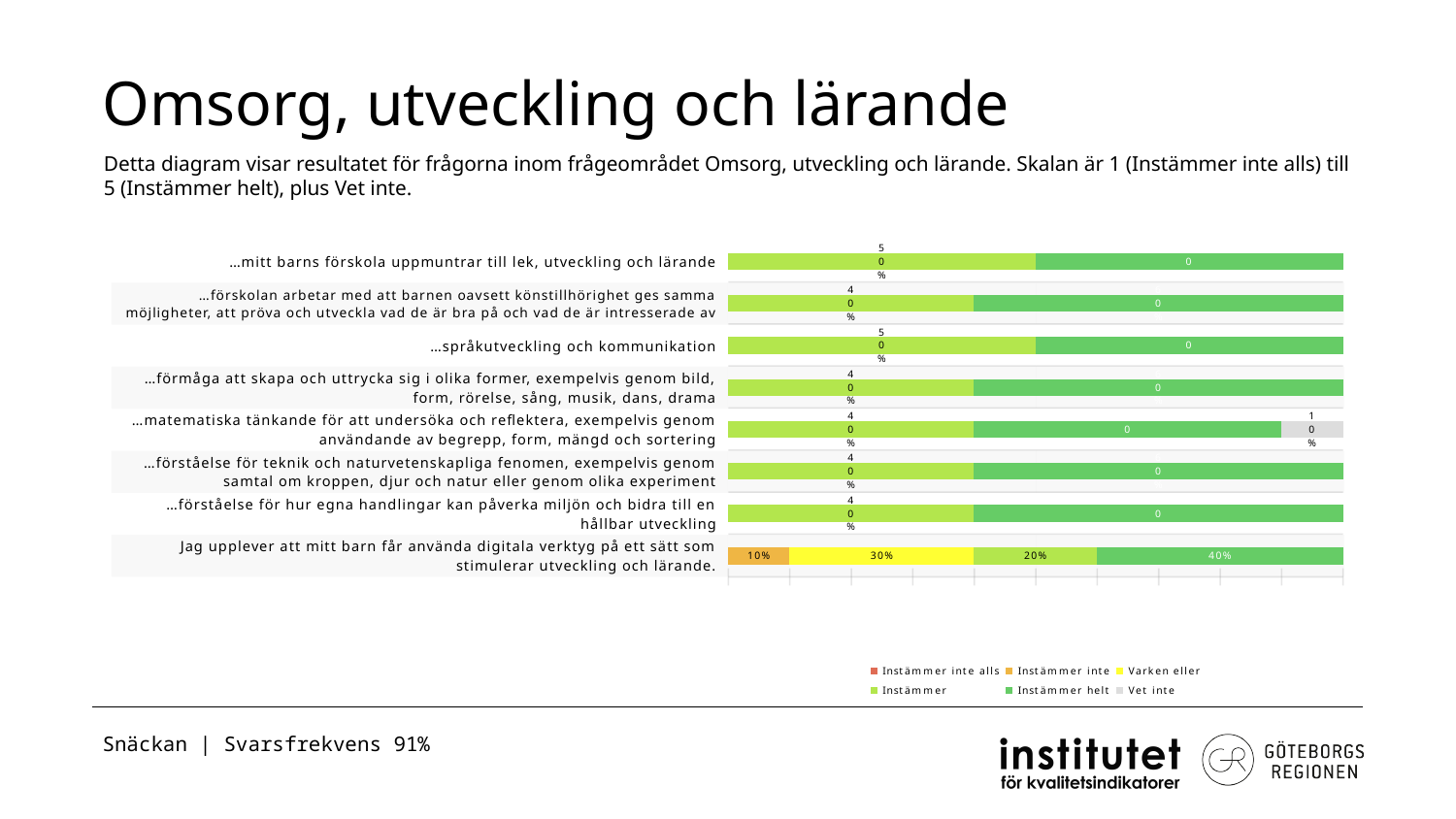
For the statement "…matematiska tänkande för att undersöka och reflektera, exempelvis genom användande av begrepp, form, mängd och sortering", what is the value for Vet inte? 10% For the statement "Jag upplever att mitt barn får använda digitala verktyg på ett sätt som stimulerar utveckling och lärande.", what is the value for Varken eller? 30% What kind of chart is shown on the slide? Stacked horizontal bar chart For the statement "Jag upplever att mitt barn får använda digitala verktyg på ett sätt som stimulerar utveckling och lärande.", what is the value for Instämmer inte? 10% Which statement is the only one with a Vet inte segment in its bar? …matematiska tänkande för att undersöka och reflektera, exempelvis genom användande av begrepp, form, mängd och sortering For the statement "…mitt barns förskola uppmuntrar till lek, utveckling och lärande", what is the value for Instämmer? 50% For the statement "Jag upplever att mitt barn får använda digitala verktyg på ett sätt som stimulerar utveckling och lärande.", what is the value for Instämmer helt? 40% How many series does the legend list? 6 For the statement "…språkutveckling och kommunikation", what is the value for Instämmer? 50% How many statements (categories) are plotted in the chart? 8 For the statement about digitala verktyg, which is larger: Instämmer helt or Varken eller? Instämmer helt For the statement about digitala verktyg, what is the difference between Instämmer helt and Instämmer inte? 30 percentage points